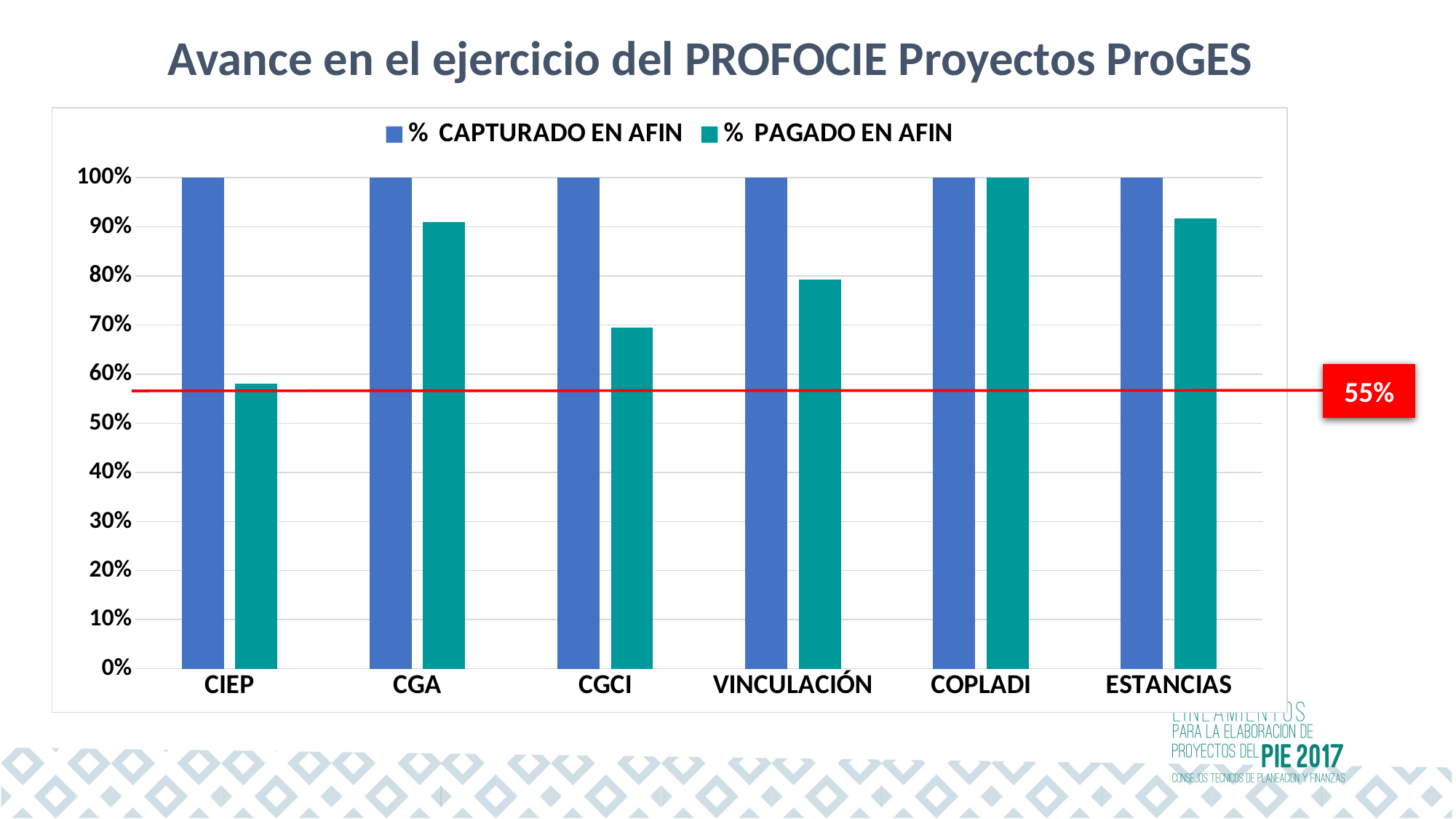
What value is labelled on the red horizontal reference line? 55% Is the % PAGADO EN AFIN value for CGA greater or less than 80%? greater What kind of chart is shown on the slide? bar chart How many categories are shown on the x axis? 6 What is the % CAPTURADO EN AFIN value for CIEP? 100% What is the difference between % CAPTURADO EN AFIN and % PAGADO EN AFIN for COPLADI? 0% Which has a larger % PAGADO EN AFIN, CGCI or VINCULACIÓN? VINCULACIÓN Which category has the highest % PAGADO EN AFIN? COPLADI What is the % PAGADO EN AFIN value for COPLADI? 100% Which category has the lowest % PAGADO EN AFIN? CIEP Is the % PAGADO EN AFIN value for CIEP greater or less than 60%? less How many series does the legend list? 2